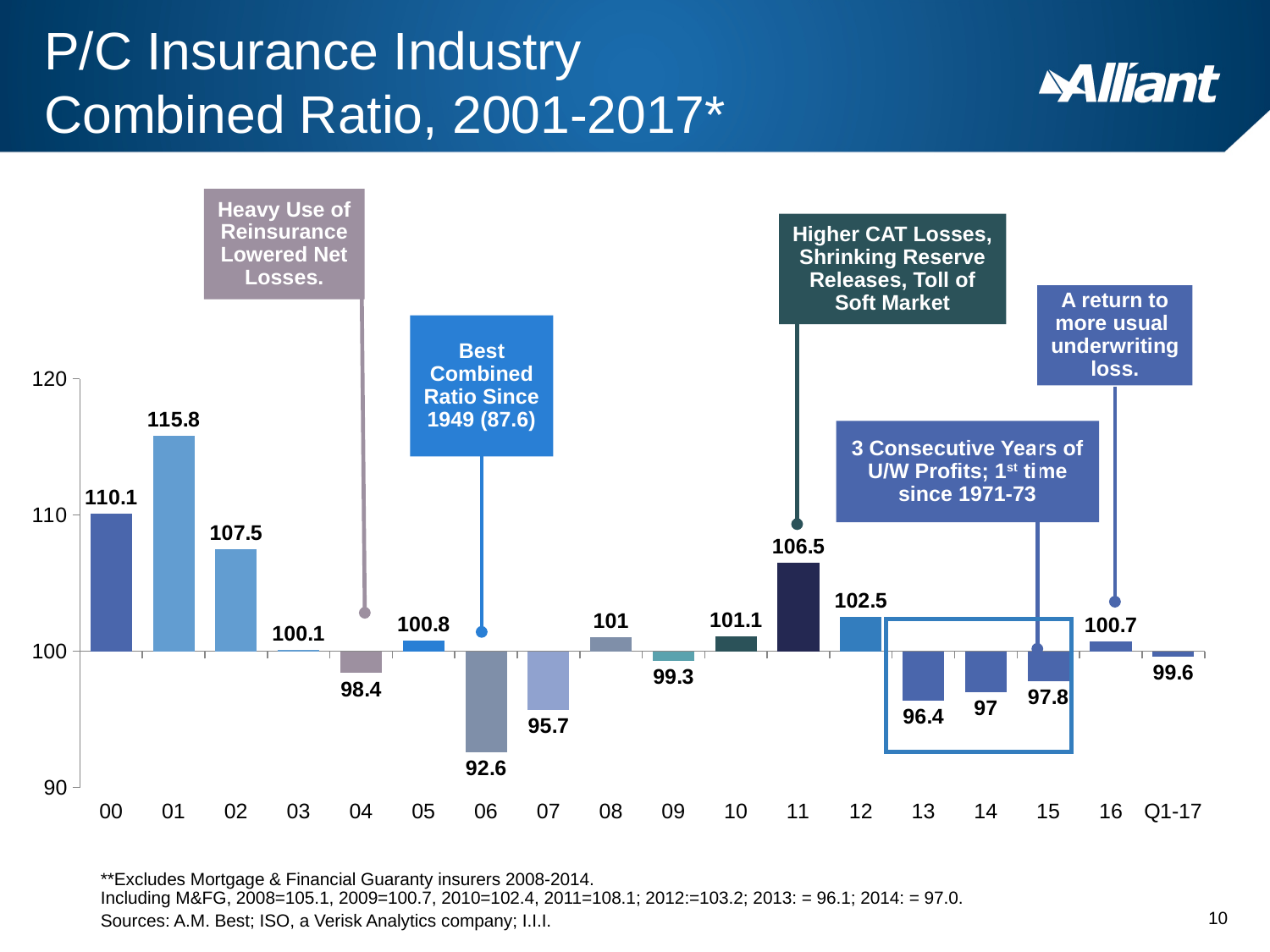
How many bars are plotted on the chart? 18 What is the difference between the combined ratio for 2001 and the combined ratio for 2000? 5.7 What is the difference between the combined ratio for 2011 and the combined ratio for 2012? 4 Which year has the lowest combined ratio on the chart? 06 Is the combined ratio for 2002 greater or less than 110? less Does the combined ratio rise or fall from 2011 to 2013? fall Which year has the highest combined ratio on the chart? 01 Which is larger, the combined ratio for 2013 or for 2015? 2015 What is the combined ratio shown for Q1-17? 99.6 What kind of chart is shown on the slide? bar chart What is the combined ratio shown for 2006? 92.6 What is the combined ratio shown for 2001? 115.8